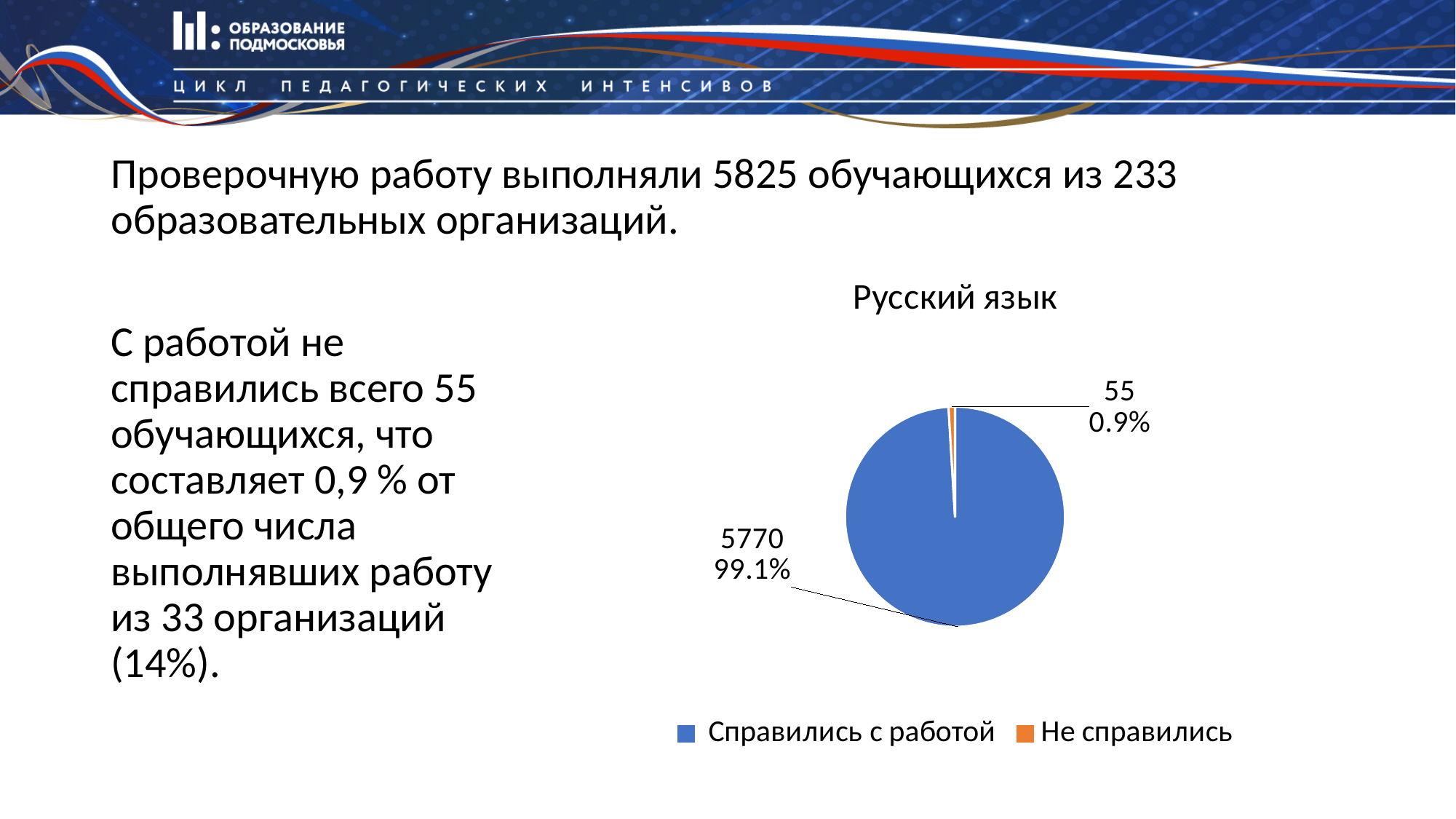
What share of the pie does "Справились с работой" represent? 99.1% What is the title of the chart? Русский язык How many slices does the pie chart have? 2 Which slice is the smallest? Не справились Which slice is the largest? Справились с работой What is the difference between the values for "Справились с работой" and "Не справились"? 5715 What is the value for "Не справились"? 55 What share of the pie does "Не справились" represent? 0.9% What is the value for "Справились с работой"? 5770 How many entries does the legend list? 2 What colour is the "Не справились" slice? Orange What kind of chart is shown on the slide? Pie chart